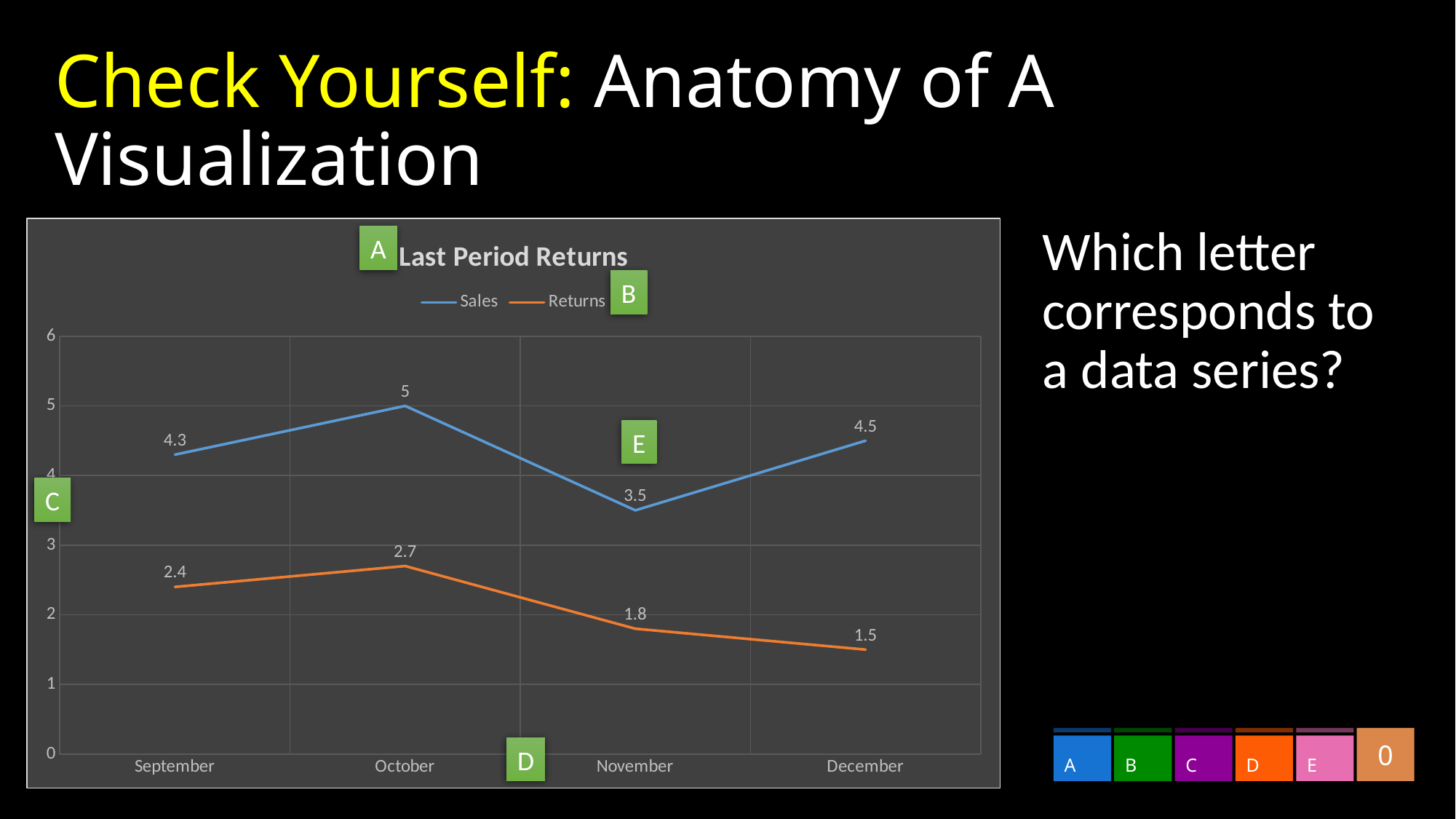
What is the Returns value for November? 1.8 What is the Sales value for December? 4.5 Which month has the lowest Sales value? November What is the Sales value for October? 5 Does the Returns series rise or fall from October to December? fall Which month has the highest Returns value? October What is the difference between Sales and Returns in September? 1.9 What kind of chart is shown? line chart How many months are shown on the x axis? 4 Which is larger, the Returns value for September or for December? September How many series does the legend list? 2 What is the title of the chart? Last Period Returns